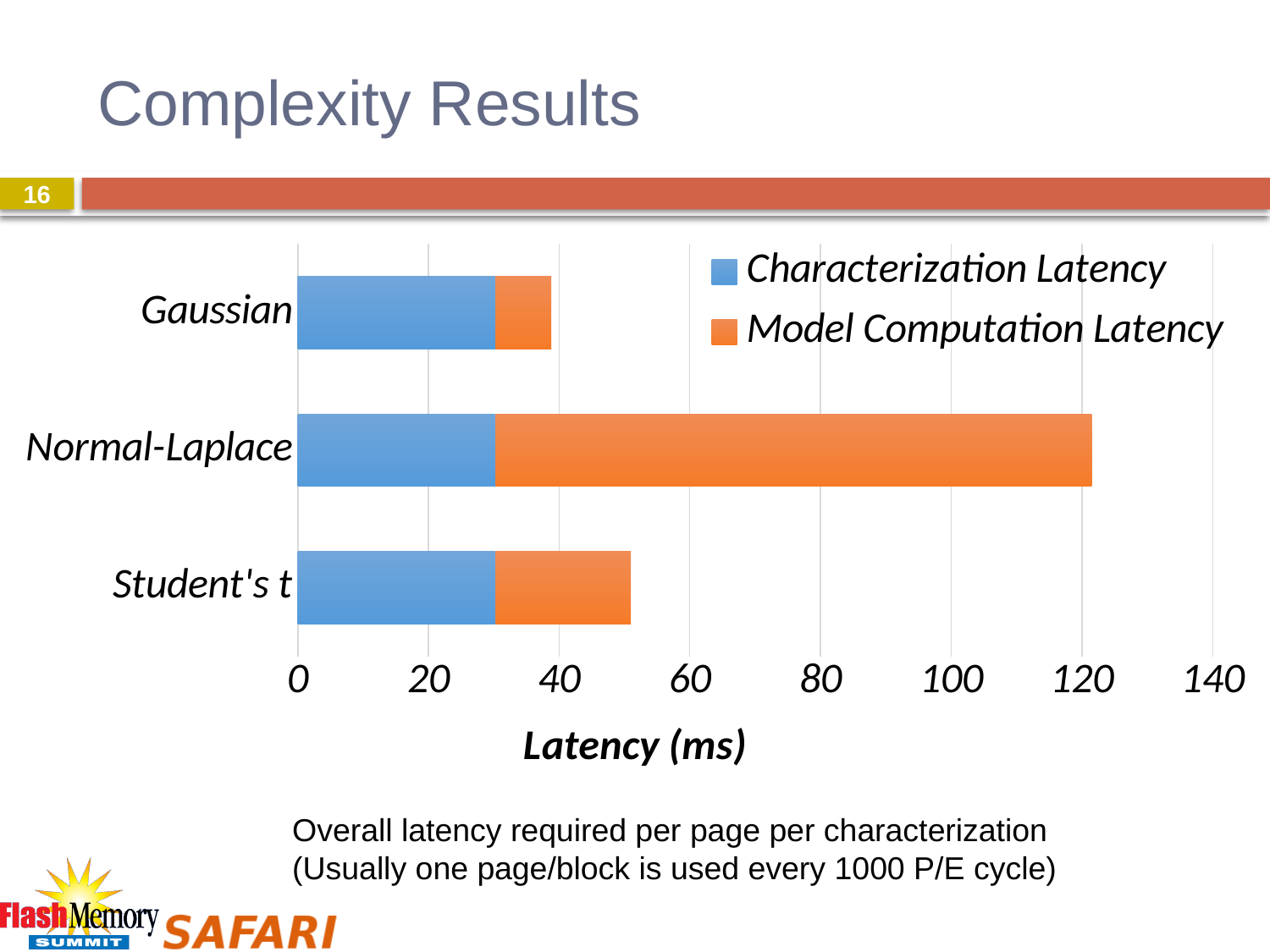
Is the total latency for Student's t greater or less than 40? greater Which category has the largest Model Computation Latency? Normal-Laplace Which has a larger total latency, Student's t or Gaussian? Student's t How many series does the legend list? 2 What is the title of the horizontal axis? Latency (ms) Which category has the lowest total latency? Gaussian Is the total latency for Normal-Laplace greater or less than 100? greater Which category has the highest total latency? Normal-Laplace How many categories are shown on the chart? 3 What kind of chart is shown on the slide? bar chart Is the total latency for Gaussian greater or less than 60? less